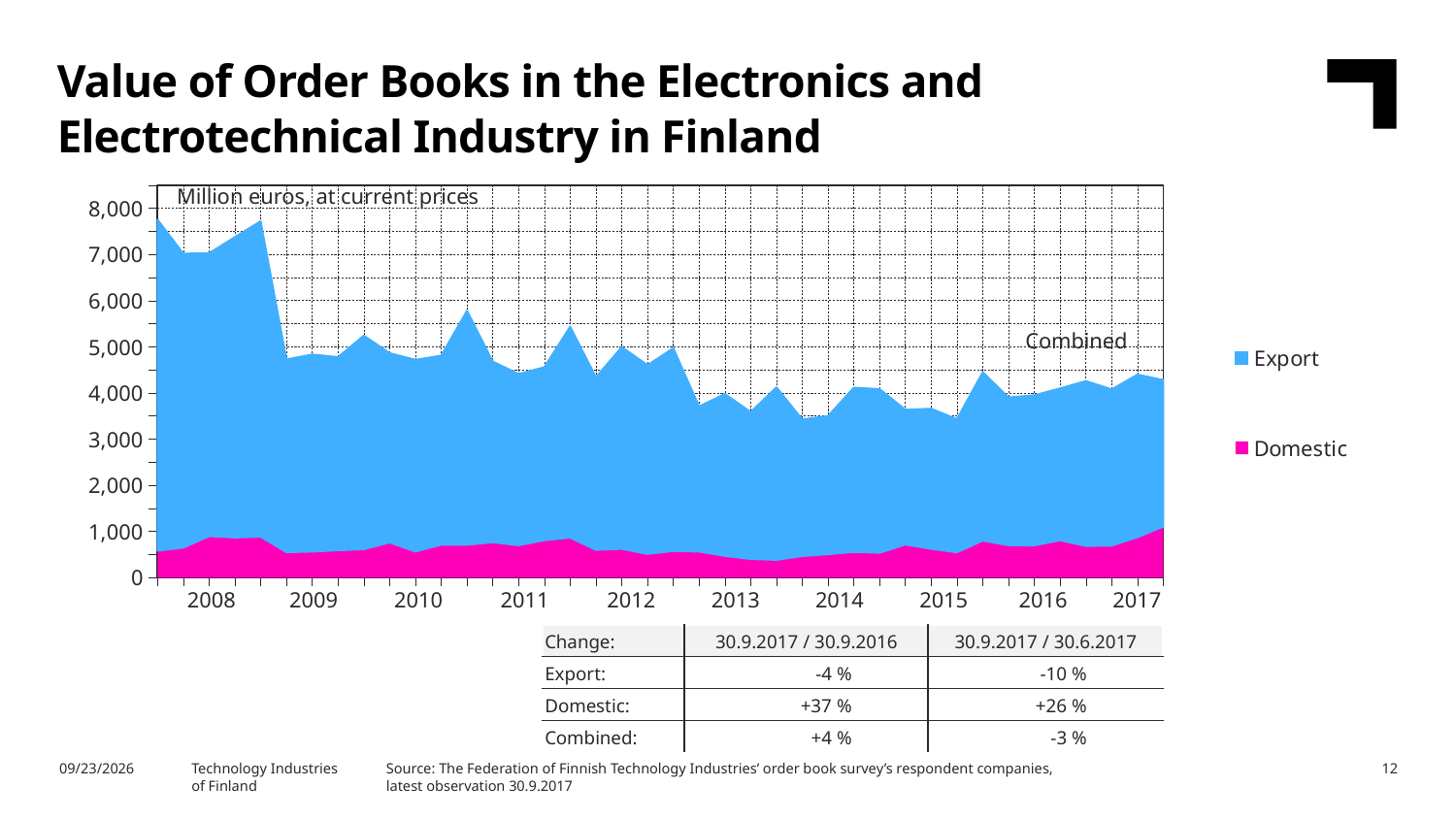
In which year does the combined value of order books reach its highest level? 2008 Is the Domestic value in 2013 greater or less than 1,000? less What kind of chart is shown on the slide? Area chart What unit does the chart's subtitle say the values are in? Million euros, at current prices How many series does the chart's legend list? 2 Which series, Export or Domestic, has the larger values throughout the chart? Export Overall, does the combined value of order books rise or fall from 2008 to 2017? fall Is the combined value in 2010 greater or less than 6,000? less Is the combined value at the start of 2008 greater or less than 7,000? greater How many years are labelled on the x axis of the chart? 10 What are the two series named in the chart's legend? Export and Domestic